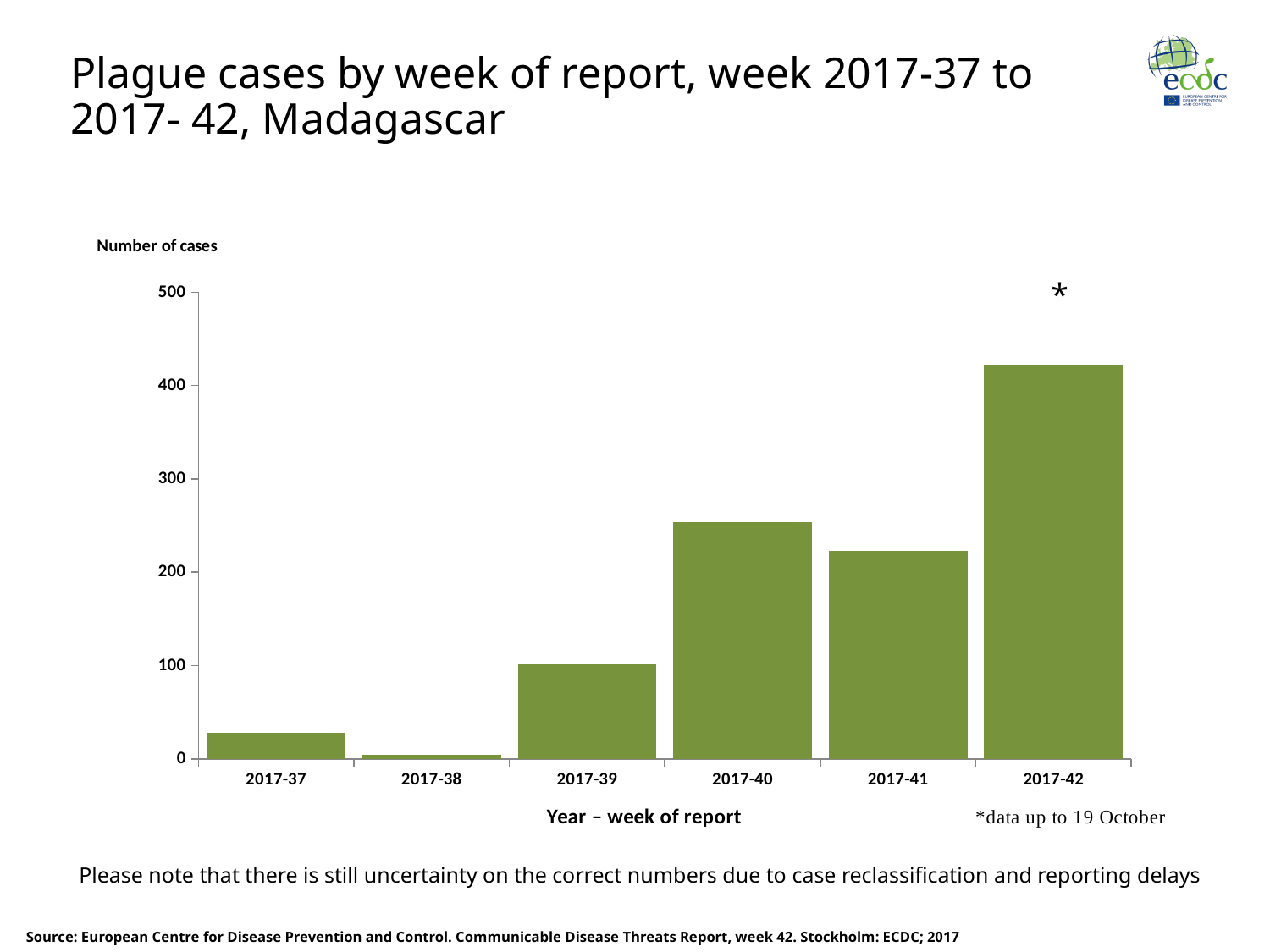
What kind of chart is shown on the slide? bar chart Is the value for 2017-40 greater or less than 300? less What is the label of the x axis? Year – week of report Which week has more cases, 2017-40 or 2017-41? 2017-40 Which week has the highest number of cases? 2017-42 Is the value for 2017-40 greater or less than 200? greater How many weeks (bars) are plotted on the chart? 6 Which week has more cases, 2017-37 or 2017-38? 2017-37 Which week has the lowest number of cases? 2017-38 Is the value for 2017-37 greater or less than 100? less Do the number of cases generally rise or fall from 2017-37 to 2017-42? rise